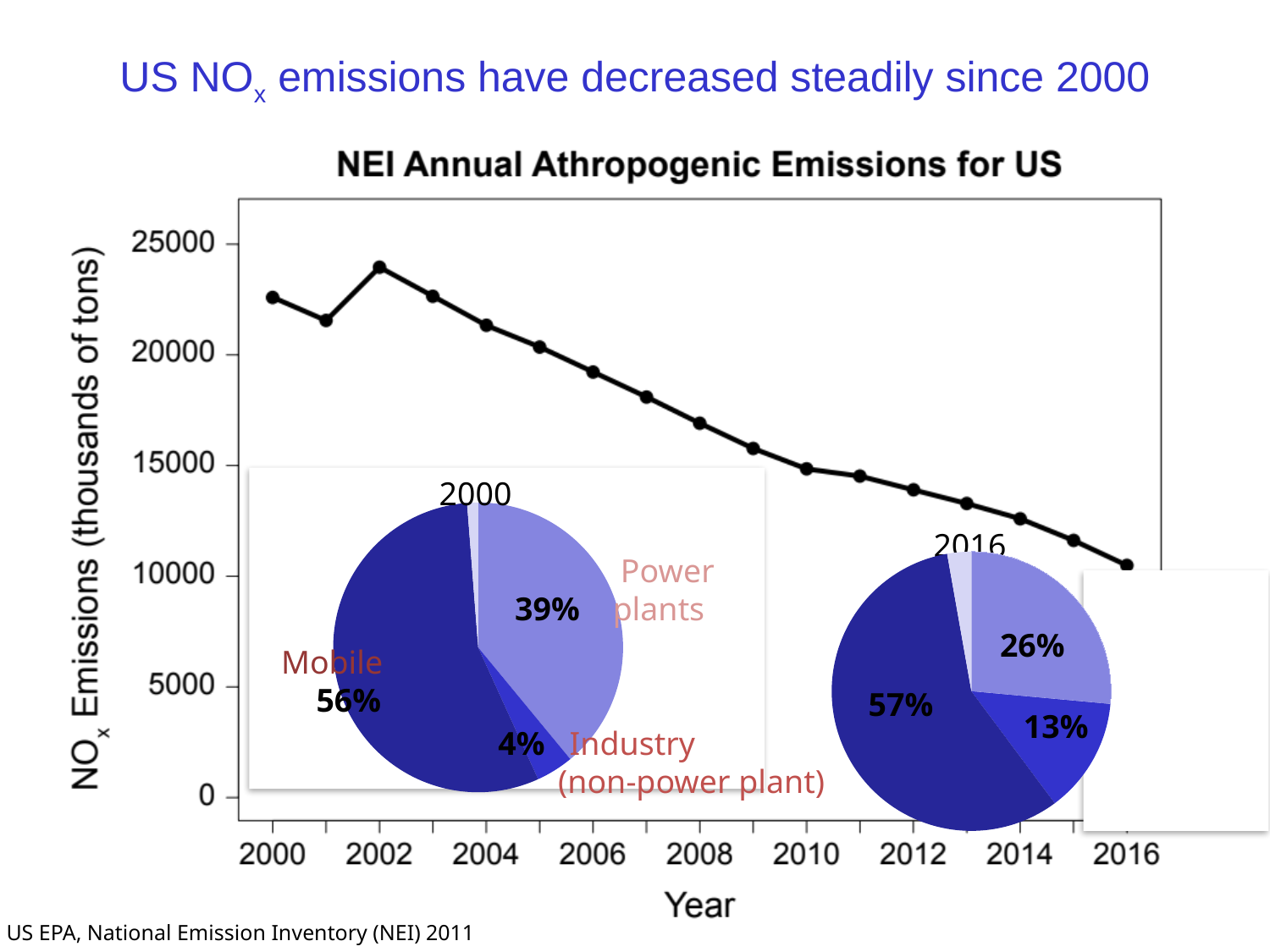
In the line chart, which year has the lowest NOx emissions? 2016 In the line chart, is the value for 2000 greater or less than 20000? greater In the 2000 pie chart, what is the difference in percentage points between the Power plants share and the Industry (non-power plant) share? 35 percentage points How many data points are plotted on the line chart? 17 In the 2000 pie chart, what share of emissions comes from Mobile sources? 56% In the line chart, do NOx emissions generally rise or fall from 2000 to 2016? fall What kind of chart is the main chart titled 'NEI Annual Athropogenic Emissions for US'? line chart In the line chart, which year has the highest NOx emissions? 2002 What is the label of the y axis on the line chart? NOx Emissions (thousands of tons) In the line chart, is the value for 2002 greater or less than 25000? less In the 2000 pie chart, what share of emissions comes from Power plants? 39% In the line chart, is the value for 2016 greater or less than 15000? less